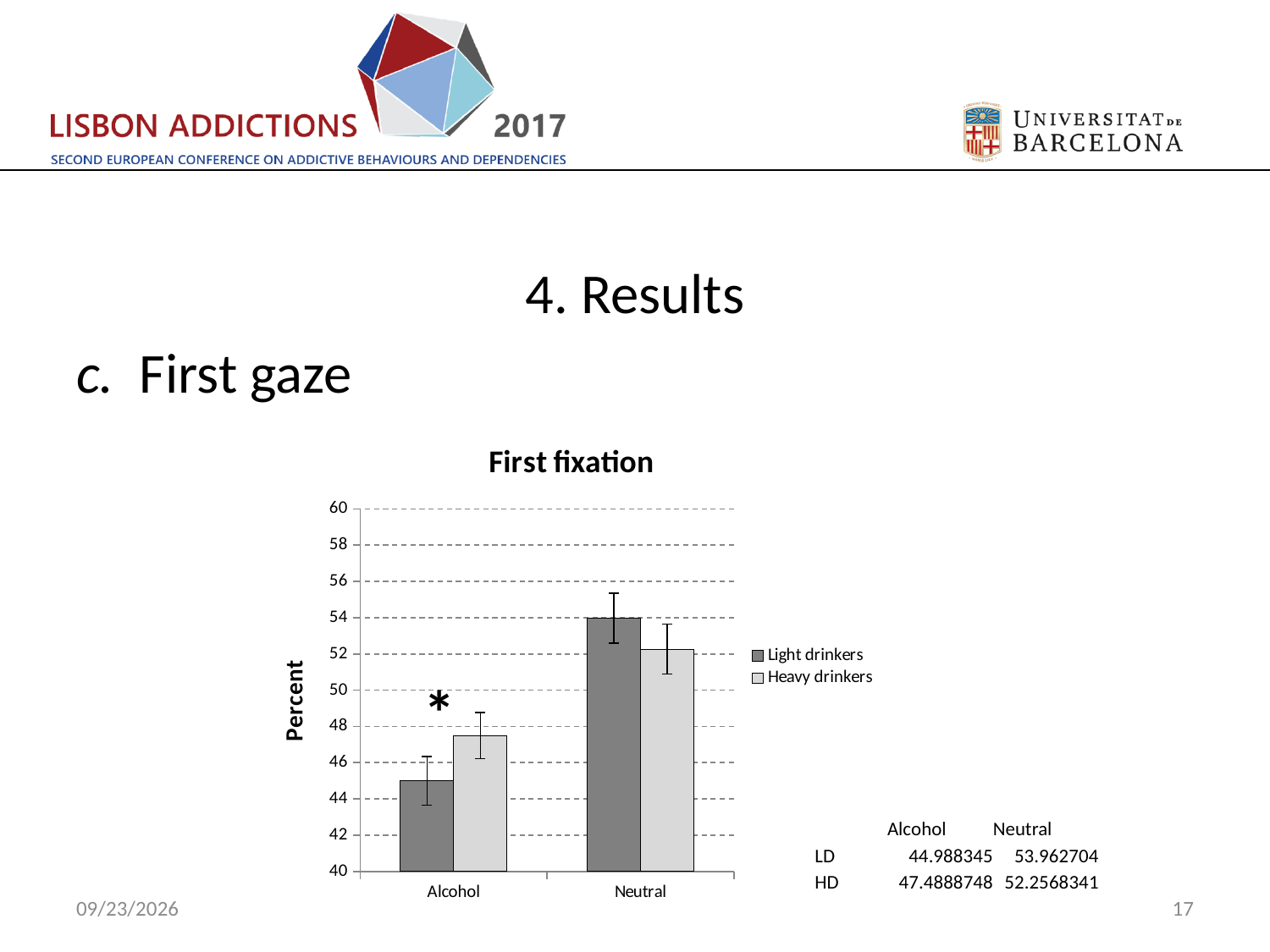
Which series is shown with the darker grey bars in the "First fixation" chart? Light drinkers How many series does the legend of the "First fixation" chart list? 2 In the "First fixation" chart, which bar is the highest? Light drinkers, Neutral In the "First fixation" chart, which bar is the lowest? Light drinkers, Alcohol What type of chart is shown under the title "First fixation"? bar chart In the "First fixation" chart, is the value for Heavy drinkers in the Neutral category greater or less than 50? greater In the "First fixation" chart, for the Neutral category, which series has the larger value, Light drinkers or Heavy drinkers? Light drinkers In the "First fixation" chart, do the values for Light drinkers rise or fall from Alcohol to Neutral? rise How many categories are shown on the x axis of the "First fixation" chart? 2 What is the title of the y axis of the "First fixation" chart? Percent In the "First fixation" chart, for the Alcohol category, which series has the larger value, Light drinkers or Heavy drinkers? Heavy drinkers In the "First fixation" chart, is the value for Light drinkers in the Alcohol category greater or less than 48? less